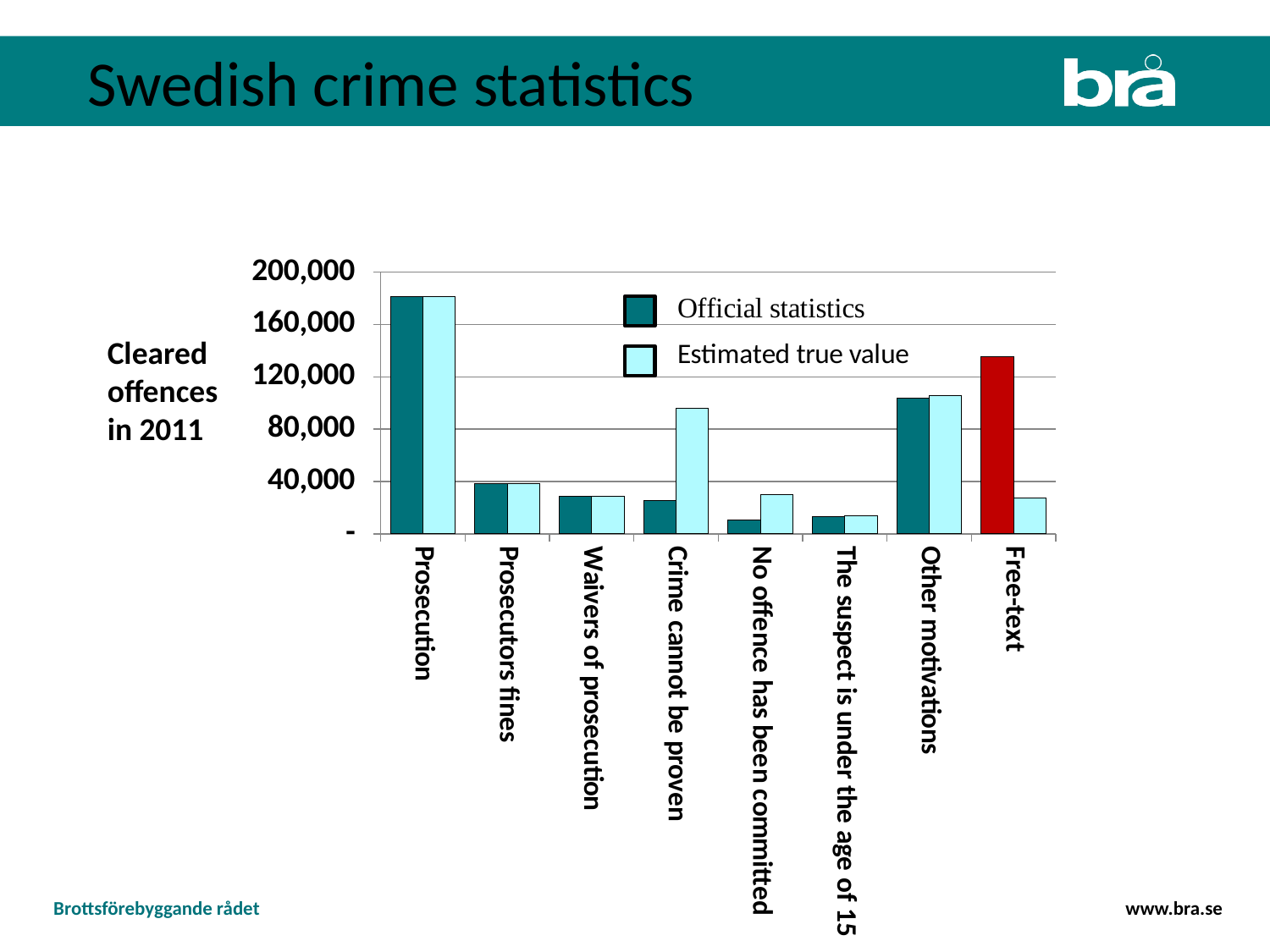
Which category has the lowest Official statistics value? No offence has been committed Is the Official statistics value for Prosecution greater or less than 160,000? greater Which category has the highest Estimated true value? Prosecution Which category has the highest Official statistics value? Prosecution What are the two series named in the chart's legend? Official statistics and Estimated true value For Free-text, which is larger: the Official statistics value or the Estimated true value? Official statistics What kind of chart is shown on the slide? bar chart Is the Estimated true value for Crime cannot be proven greater or less than 80,000? greater For Crime cannot be proven, which is larger: the Official statistics value or the Estimated true value? Estimated true value How many series does the chart's legend list? 2 How many categories are shown on the x axis of the chart? 8 Is the Official statistics value for Free-text greater or less than 120,000? greater